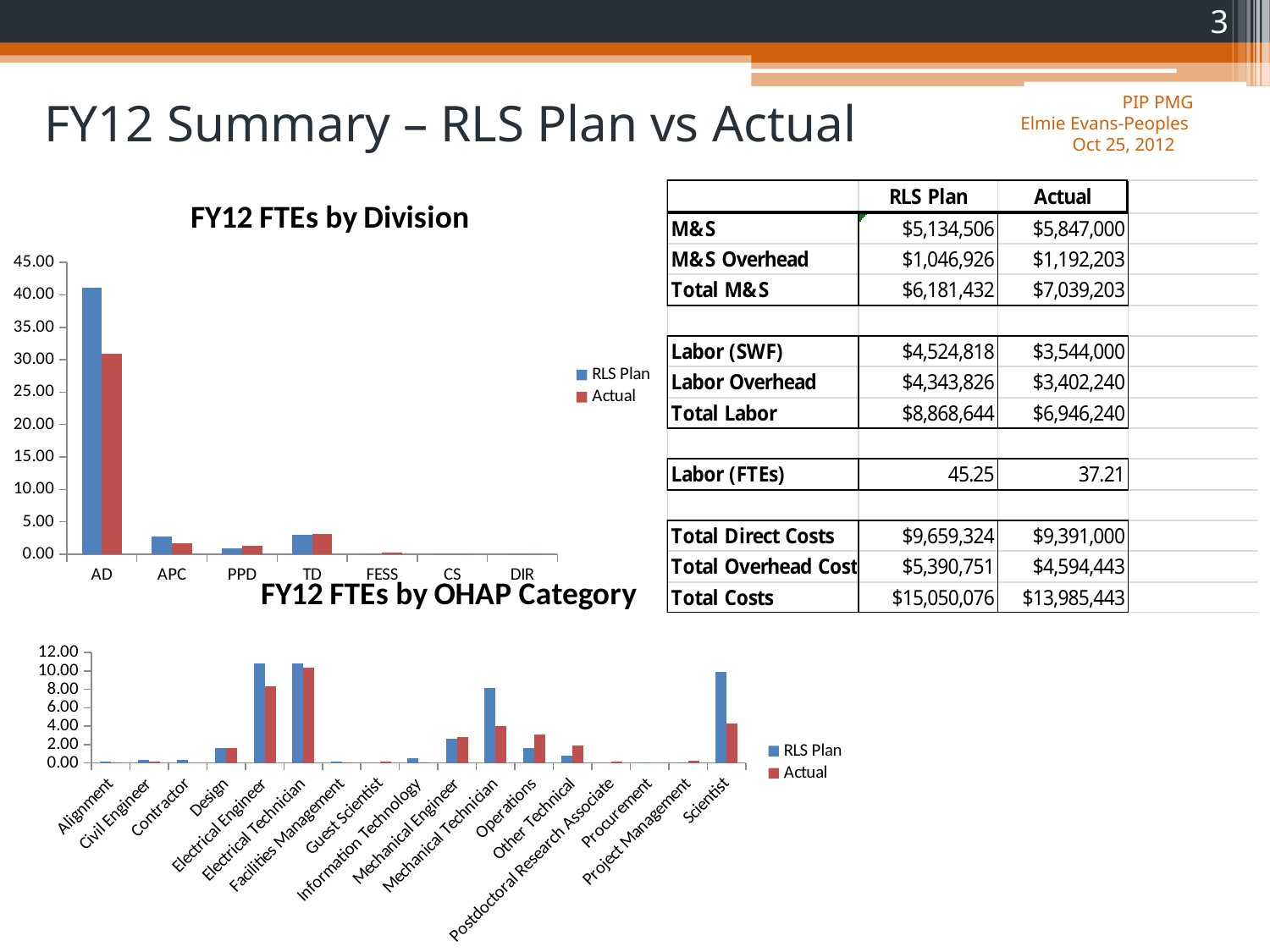
In the "FY12 FTEs by Division" chart, is the RLS Plan value for AD greater or less than 35? greater In the "FY12 FTEs by Division" chart, which is larger for APC, the RLS Plan value or the Actual value? RLS Plan In the "FY12 FTEs by OHAP Category" chart, is the RLS Plan value for Mechanical Technician greater or less than 6.00? greater In the "FY12 FTEs by OHAP Category" chart, which category has the highest Actual value? Electrical Technician How many series does the legend of the "FY12 FTEs by Division" chart list? 2 In the "FY12 FTEs by OHAP Category" chart, which is larger for Scientist, the RLS Plan value or the Actual value? RLS Plan How many categories are shown on the x axis of the "FY12 FTEs by OHAP Category" chart? 17 In the "FY12 FTEs by Division" chart, is the Actual value for AD greater or less than 25? greater How many divisions are shown on the x axis of the "FY12 FTEs by Division" chart? 7 In the "FY12 FTEs by Division" chart, which division has the highest RLS Plan value? AD What kind of chart is the "FY12 FTEs by Division" chart? bar chart What are the two legend entries of the "FY12 FTEs by OHAP Category" chart? RLS Plan and Actual